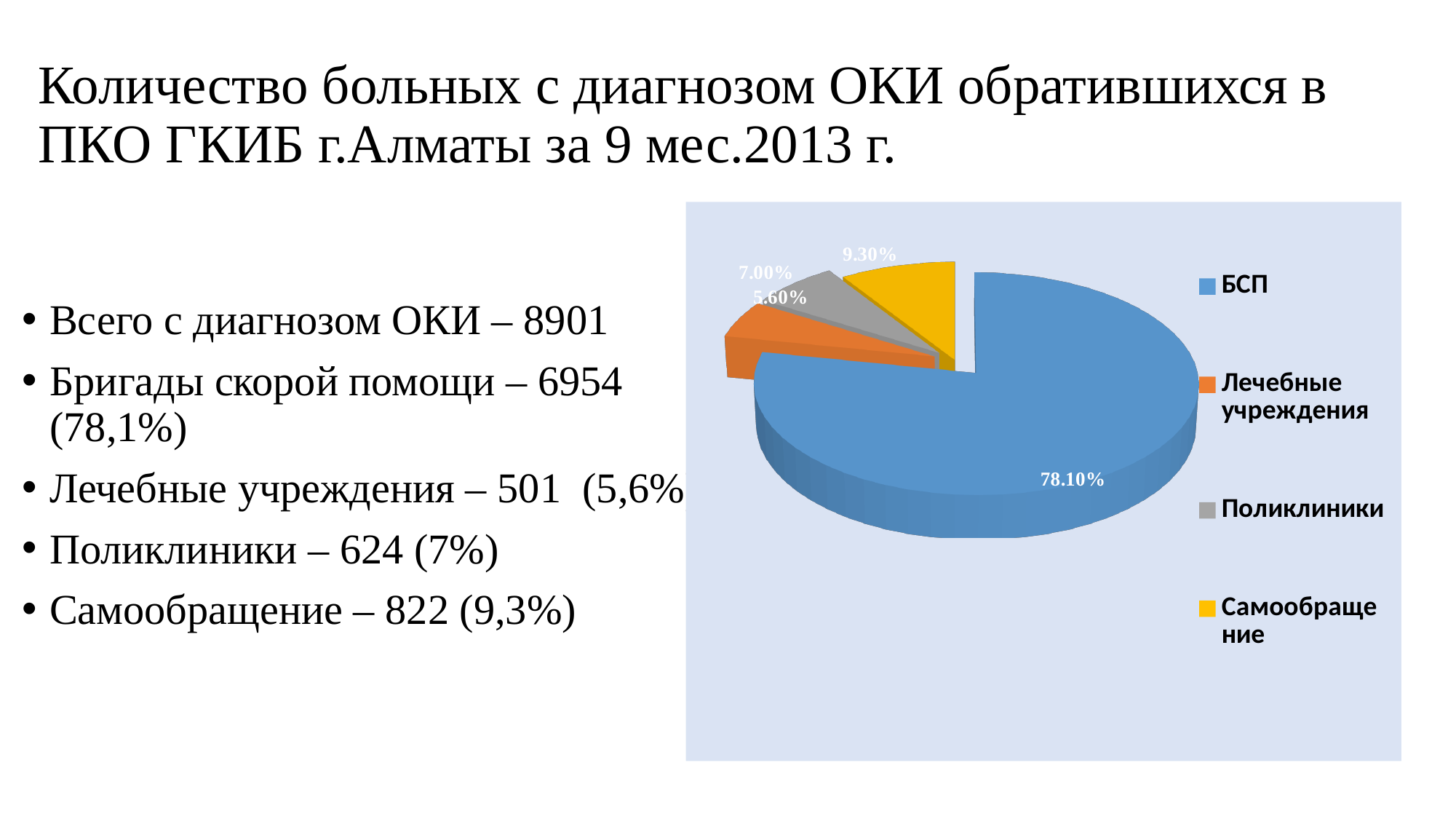
Which category has the smallest slice of the pie? Лечебные учреждения What share of the pie does БСП account for? 78.10% What share of the pie does Поликлиники account for? 7.00% What kind of chart is shown on the slide? pie chart What share of the pie does Лечебные учреждения account for? 5.60% Which slice is larger: Самообращение or Поликлиники? Самообращение Which category has the largest slice of the pie? БСП What colour is the БСП slice in the pie chart? blue What share of the pie does Самообращение account for? 9.30% What is the difference in percentage points between the Самообращение slice and the Лечебные учреждения slice? 3.70% What is the difference in percentage points between the БСП slice and the Поликлиники slice? 71.10% How many slices does the pie chart have? 4